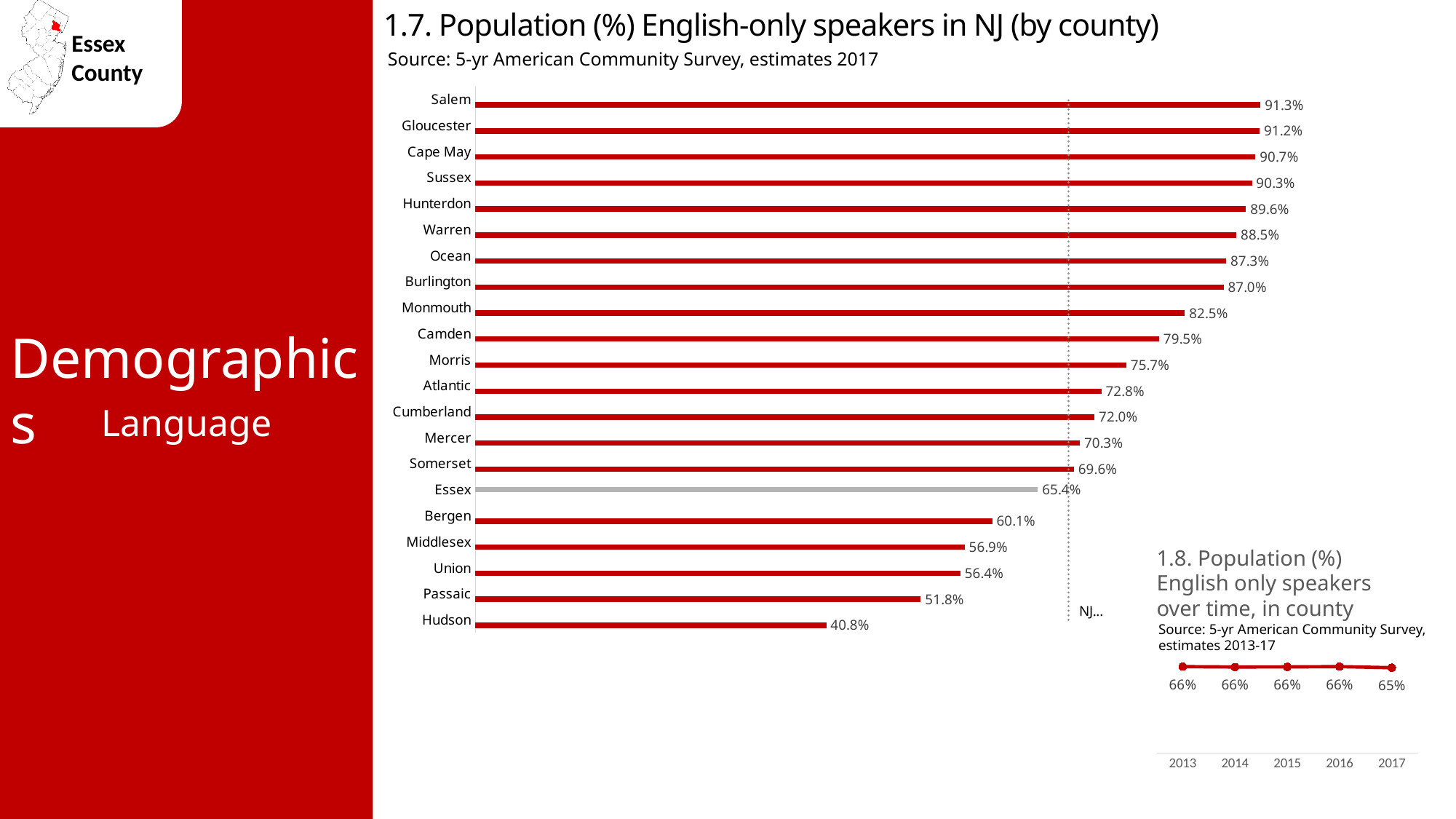
In chart 1.7, how many counties are shown? 21 In chart 1.8, what is the value for 2017? 65% In chart 1.7, which is larger, the value for Bergen or the value for Passaic? Bergen In chart 1.7, which bar is shown in grey rather than red? Essex In chart 1.7, what is the value for Essex? 65.4% In chart 1.7, what is the difference between the values for Salem and Hudson? 50.5% In chart 1.7, which county has the highest percentage of English-only speakers? Salem In chart 1.8, how many years are plotted? 5 In chart 1.7, what is the value for Monmouth? 82.5% What kind of chart is chart 1.7? Bar chart In chart 1.7, what is the value for Hudson? 40.8% In chart 1.7, which county has the lowest percentage of English-only speakers? Hudson